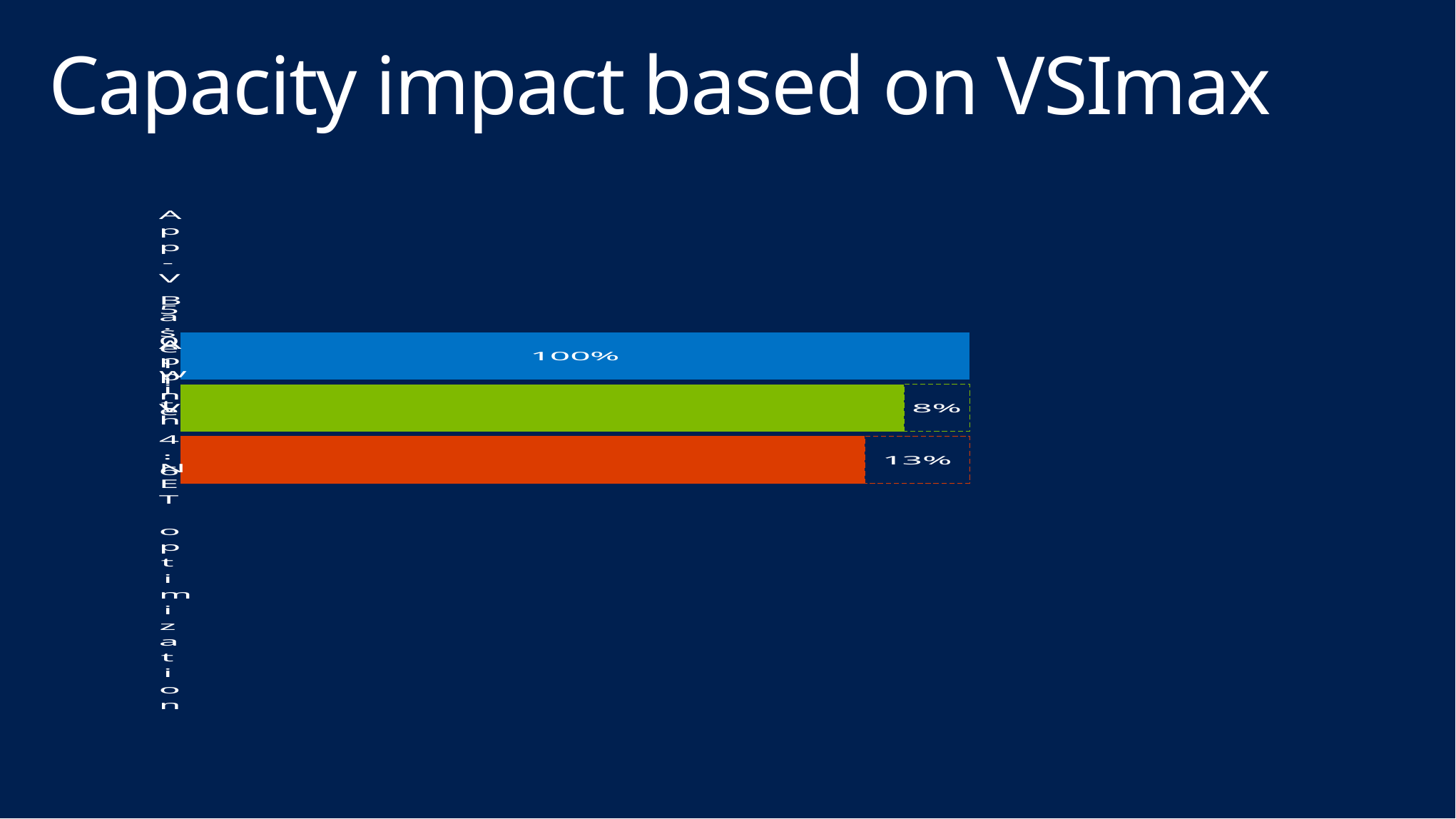
What colour is the top bar in the chart? blue Which bar is longer, the green bar or the red bar? the green bar What kind of chart is shown on the slide? bar chart Which bar is the longest in the chart? the blue bar How many bars does the chart contain? 3 What is the difference between the value printed on the red bar and the value printed on the green bar? 5% What value is printed on the blue bar? 100% What value is printed next to the green bar? 8% What is the title of the slide containing the chart? Capacity impact based on VSImax Which bar is the shortest in the chart? the red bar What value is printed next to the red bar? 13%